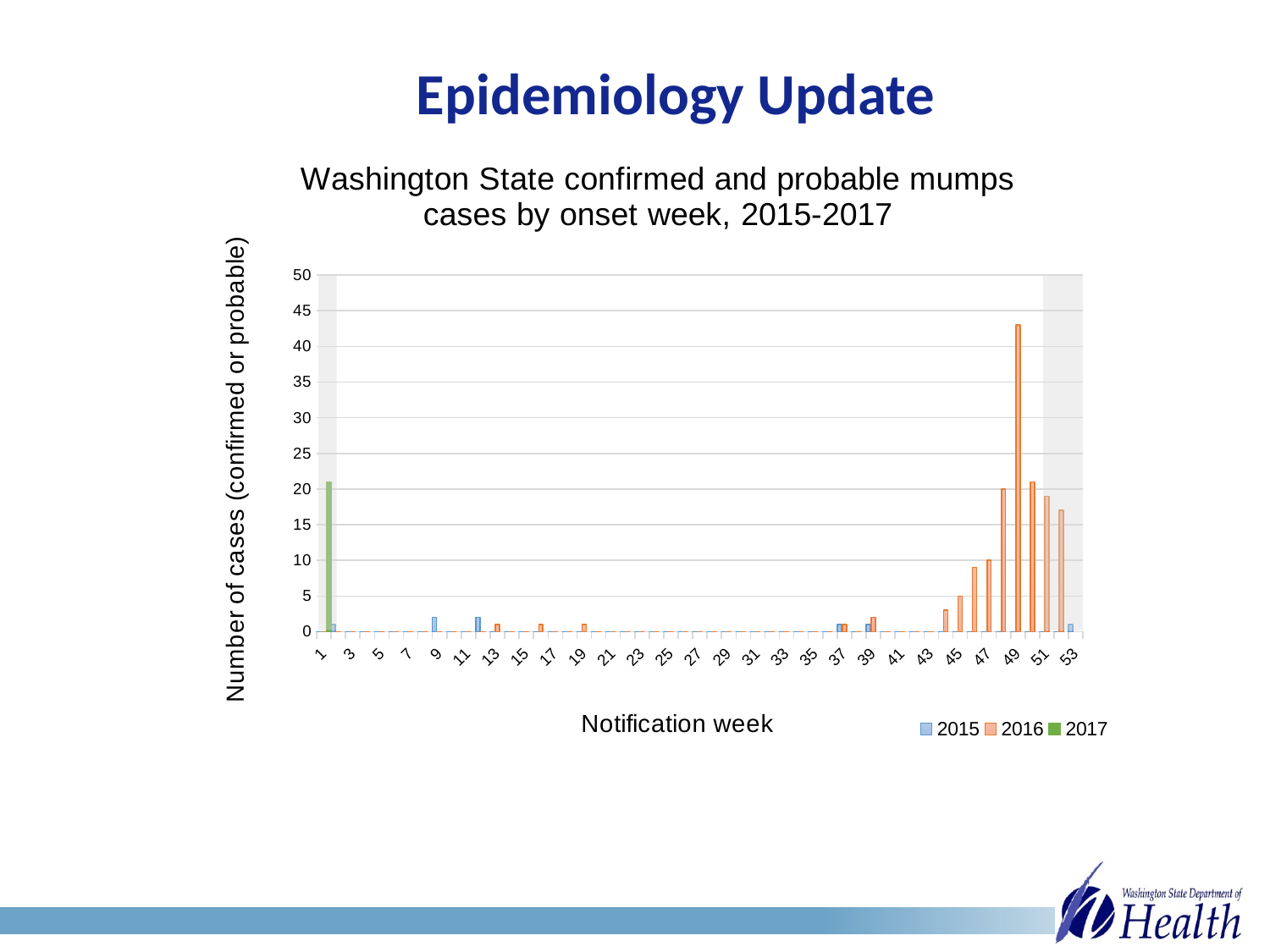
What kind of chart is shown on the slide? Bar chart Which is larger: the 2016 value for week 49 or the 2016 value for week 51? Week 49 Which series contains the tallest bar on the chart? 2016 Is the 2016 value for week 45 greater or less than 10? less Is the 2016 value for week 47 greater or less than 15? less Which years are listed in the chart legend? 2015, 2016, 2017 In which notification week does the 2016 series reach its highest value? Week 49 How many series does the legend list? 3 Is the 2016 value for week 49 greater or less than 40? greater What is the title of the x axis? Notification week Which is larger: the 2017 value for week 1 or the 2016 value for week 47? 2017 value for week 1